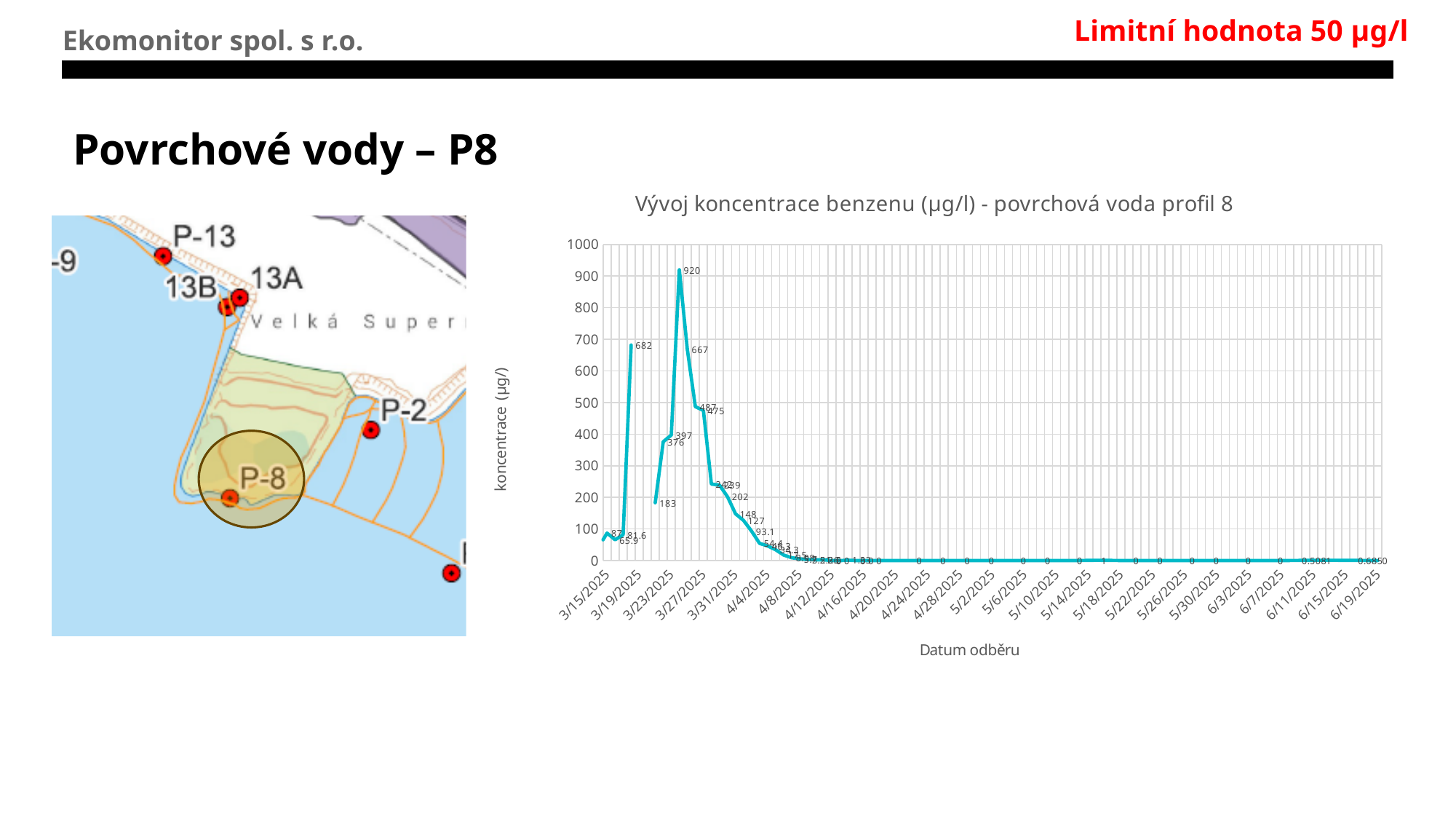
Which labeled value is larger, 682 or 667? 682 What is the value labeled at the last data point (6/19/2025)? 0 What kind of chart is shown on the slide? line chart Is the value on 5/14/2025 greater or less than 100? less How many lines (data series) are plotted on the chart? 1 What is the highest benzene concentration value labeled on the chart? 920 Do the values rise or fall between 3/27/2025 and 4/20/2025? fall What is the difference between the peak value 920 and the following labeled value 667? 253 What is the label of the vertical axis of the chart? koncentrace (µg/l) What is the title of the chart? Vývoj koncentrace benzenu (µg/l) - povrchová voda profil 8